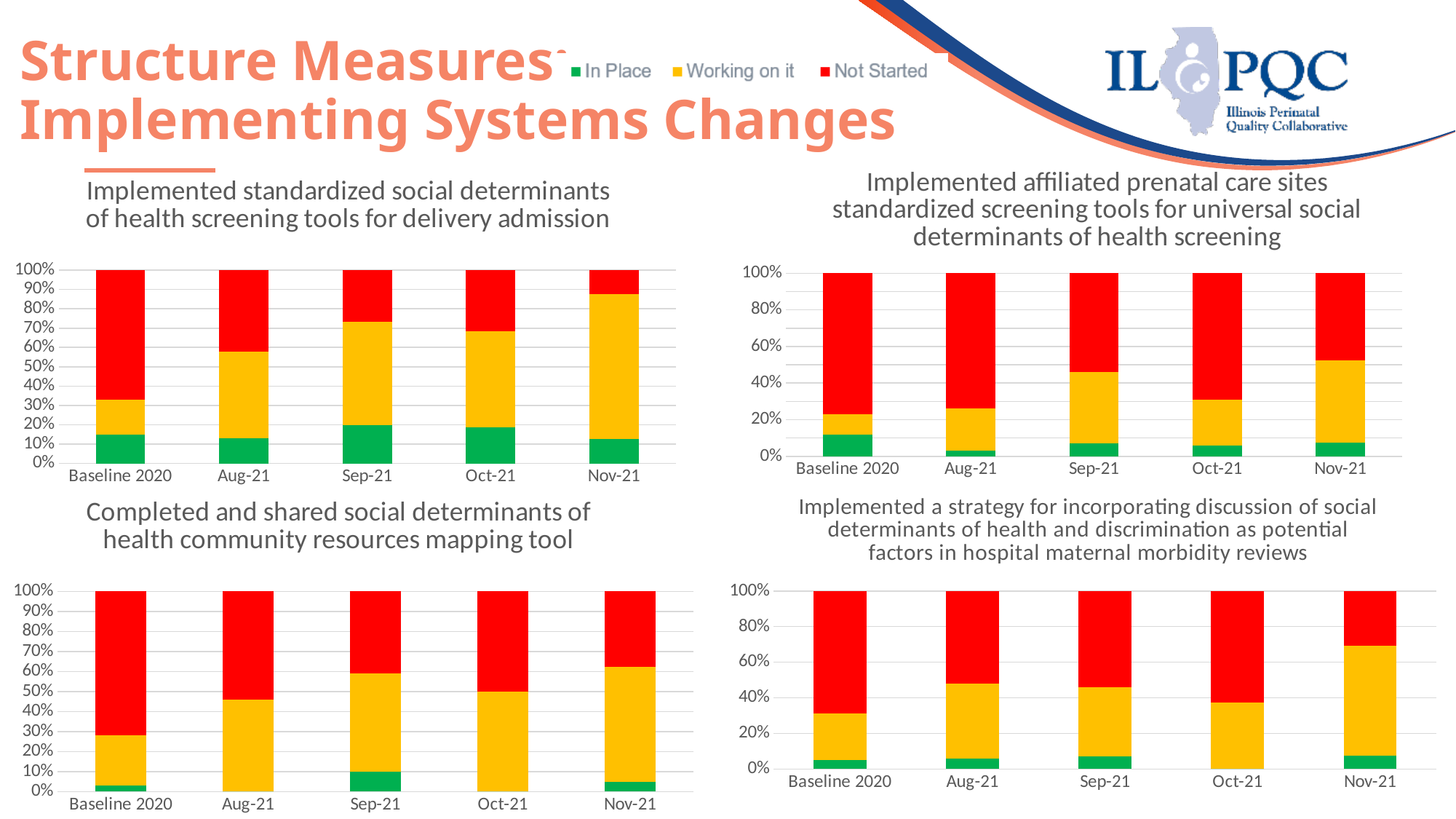
In the chart 'Implemented standardized social determinants of health screening tools for delivery admission', is the Not Started share for Nov-21 greater or less than 20%? less In the chart 'Implemented standardized social determinants of health screening tools for delivery admission', is the Not Started share for Baseline 2020 greater or less than 50%? greater What is the first category label on the x axis of the chart 'Completed and shared social determinants of health community resources mapping tool'? Baseline 2020 What are the three legend entries shown at the top of the slide? In Place, Working on it, Not Started In the chart 'Implemented standardized social determinants of health screening tools for delivery admission', which period has the smallest Not Started share? Nov-21 In the chart 'Implemented affiliated prenatal care sites standardized screening tools for universal social determinants of health screening', which has the larger Not Started share, Baseline 2020 or Nov-21? Baseline 2020 In the chart 'Implemented standardized social determinants of health screening tools for delivery admission', how many time periods are shown on the x axis? 5 In the chart 'Completed and shared social determinants of health community resources mapping tool', which period has the largest Not Started share? Baseline 2020 In the chart 'Implemented a strategy for incorporating discussion of social determinants of health and discrimination as potential factors in hospital maternal morbidity reviews', is the Not Started share for Nov-21 greater or less than 40%? less In the chart 'Implemented a strategy for incorporating discussion of social determinants of health and discrimination as potential factors in hospital maternal morbidity reviews', which has the larger Working on it share, Oct-21 or Nov-21? Nov-21 How many series does the legend at the top of the slide list? 3 What kind of chart is used for 'Implemented standardized social determinants of health screening tools for delivery admission'? Stacked bar chart